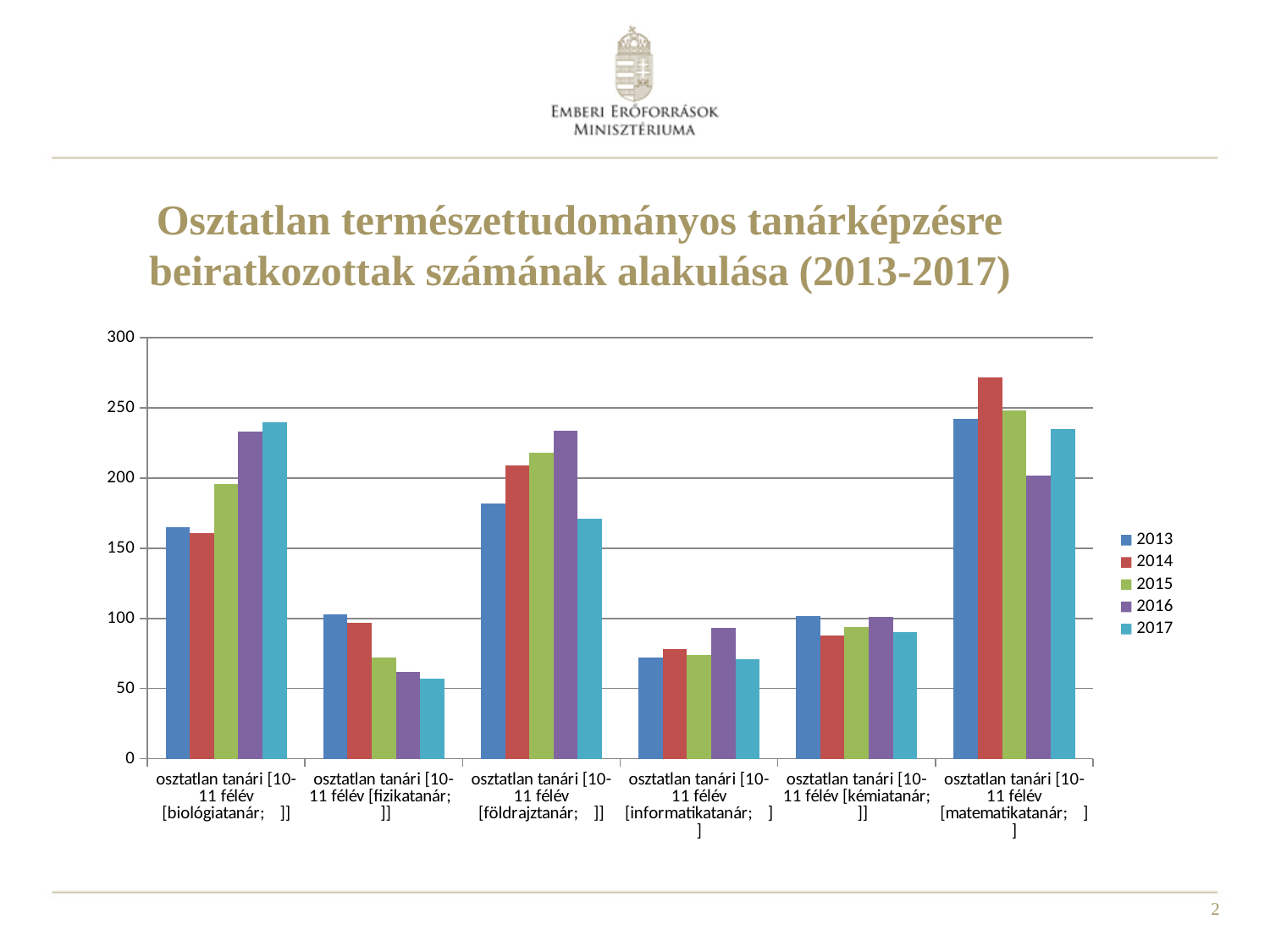
What kind of chart is shown on the slide? bar chart How many series does the legend list? 5 For 2013, which is larger: the value for kémiatanár or the value for informatikatanár? kémiatanár Which year is listed first in the legend? 2013 Which category has the highest bar for 2014? osztatlan tanári [10-11 félév [matematikatanár; ]] For 2016, which is larger: the value for földrajztanár or the value for matematikatanár? földrajztanár Do the bars for fizikatanár rise or fall from 2013 to 2017? fall Which category has the lowest bar for 2017? osztatlan tanári [10-11 félév [fizikatanár; ]] Is the 2016 value for fizikatanár greater or less than 100? less How many teacher-training categories are shown on the x axis? 6 Is the 2017 value for biológiatanár greater or less than 200? greater Is the 2014 value for matematikatanár greater or less than 250? greater